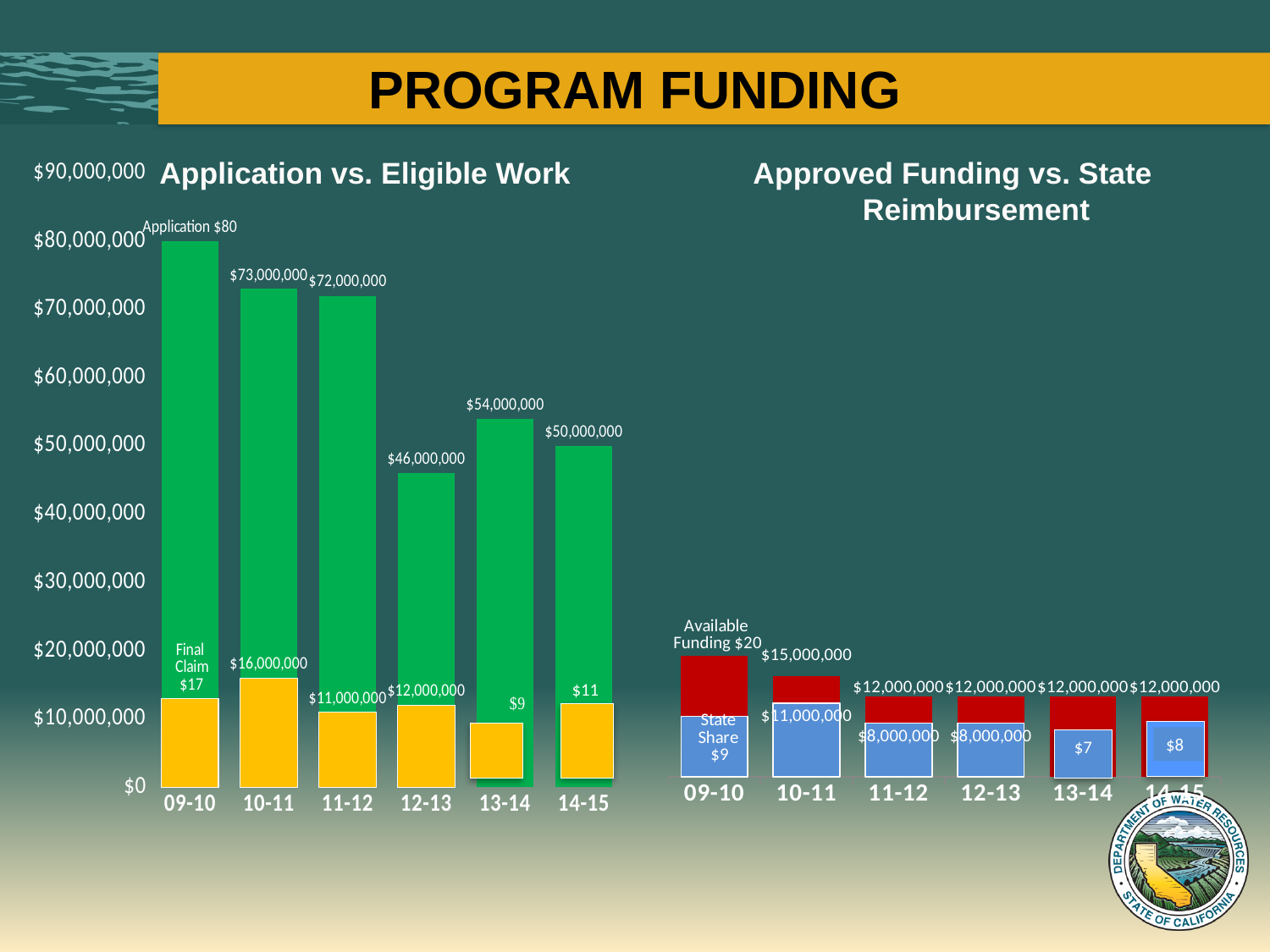
In the Application vs. Eligible Work chart, which year has the highest Application value? 09-10 In the Application vs. Eligible Work chart, which year has the lowest Application value? 12-13 In the Application vs. Eligible Work chart, what is the Final Claim value for 10-11? $16,000,000 In the Application vs. Eligible Work chart, what is the Application value for 10-11? $73,000,000 In the Application vs. Eligible Work chart, what is the difference between the Application values for 10-11 and 11-12? $1,000,000 In the Approved Funding vs. State Reimbursement chart, what is the Available Funding value for 10-11? $15,000,000 In the Application vs. Eligible Work chart, what is the Application value for 12-13? $46,000,000 What type of chart is the Application vs. Eligible Work chart? Bar chart In the Application vs. Eligible Work chart, which year has the larger Application value, 13-14 or 14-15? 13-14 How many years are shown on the x axis of the Approved Funding vs. State Reimbursement chart? 6 In the Approved Funding vs. State Reimbursement chart, what is the difference between Available Funding and State Share for 10-11? $4,000,000 In the Approved Funding vs. State Reimbursement chart, what is the State Share value for 10-11? $11,000,000